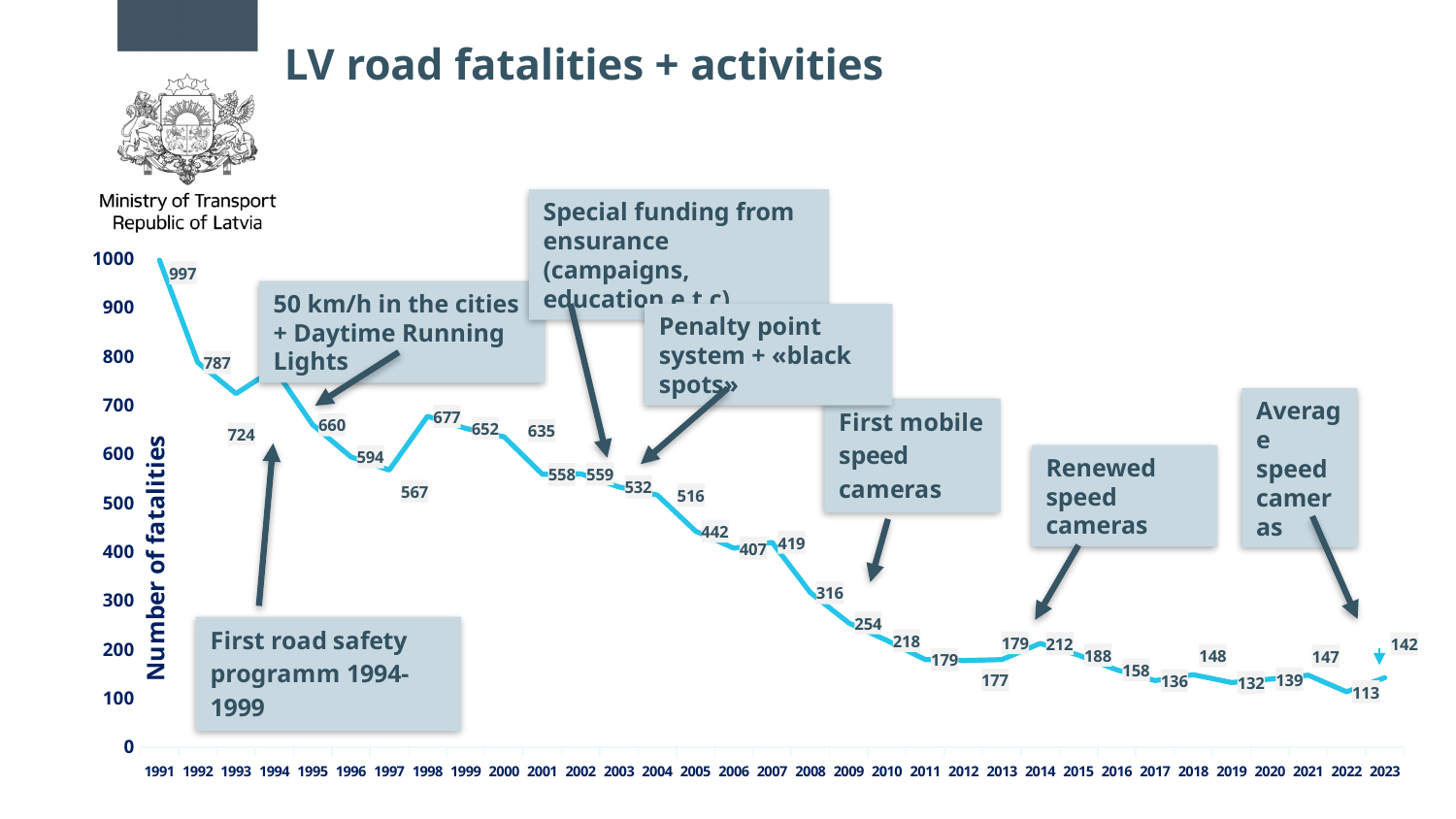
What is the difference between the fatalities in 1991 and in 2023? 855 What is the title of the y axis? Number of fatalities What is the number of road fatalities shown for 1991? 997 Do the fatality numbers generally rise or fall from 1991 to 2023? Fall Which year has the highest number of fatalities? 1991 What is the number of road fatalities shown for 2023? 142 How many years are shown on the x axis? 33 What is the number of road fatalities shown for 2008? 316 Which year has the lowest number of fatalities? 2022 Which year had more fatalities, 1997 or 1998? 1998 Is the value for 1994 greater or less than 700? greater What kind of chart is shown on the slide? Line chart